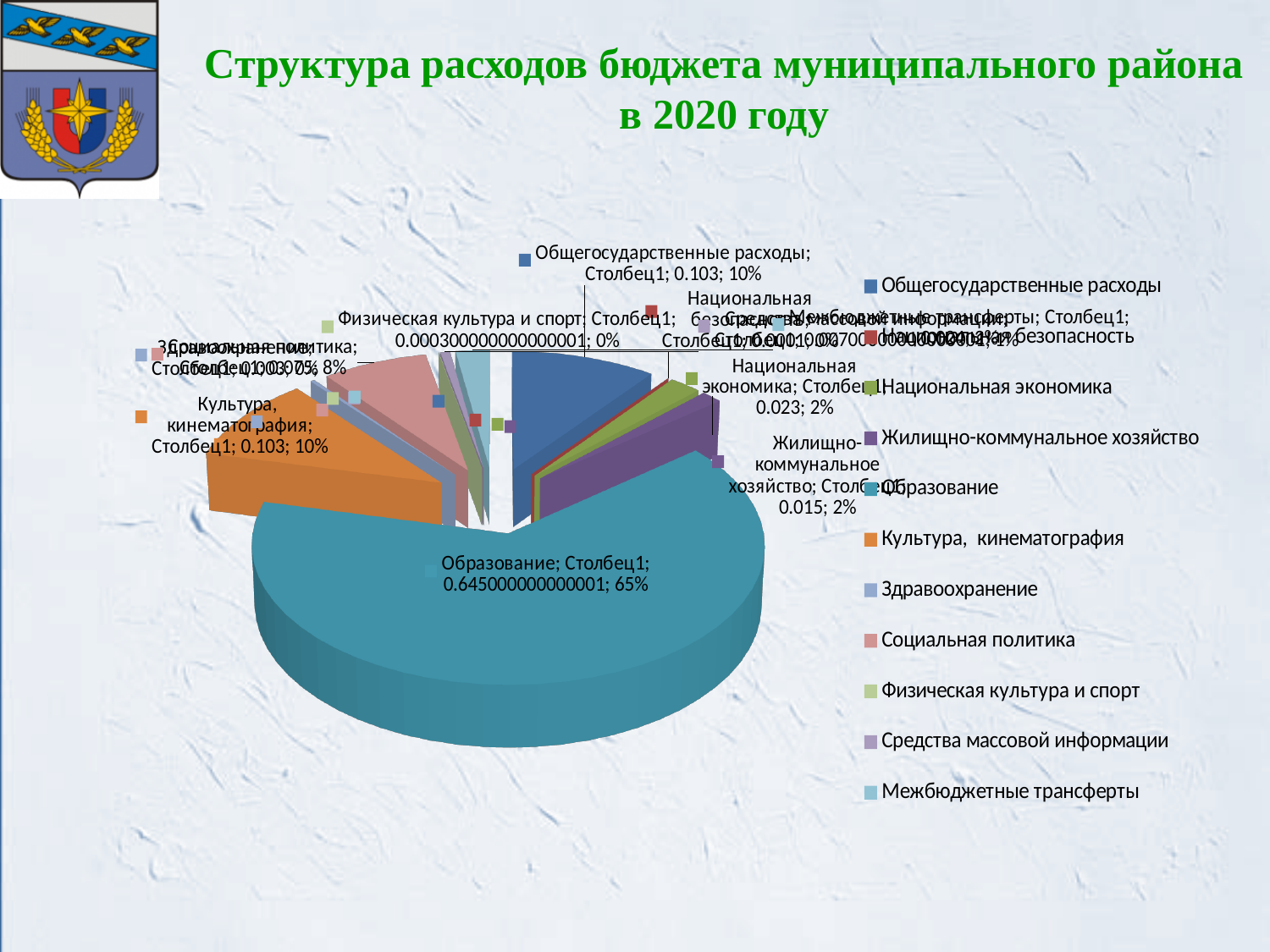
What share of the pie does Образование have? 65% Which is larger, the share for Образование or the share for Культура, кинематография? Образование What is the title of the chart? Структура расходов бюджета муниципального района в 2020 году What share of the pie does Жилищно-коммунальное хозяйство have? 2% What share of the pie does Культура, кинематография have? 10% What kind of chart is shown on the slide? pie chart How many categories does the legend list? 11 Which category has the largest share of the pie? Образование What is the difference in percentage points between the share for Образование and the share for Общегосударственные расходы? 55